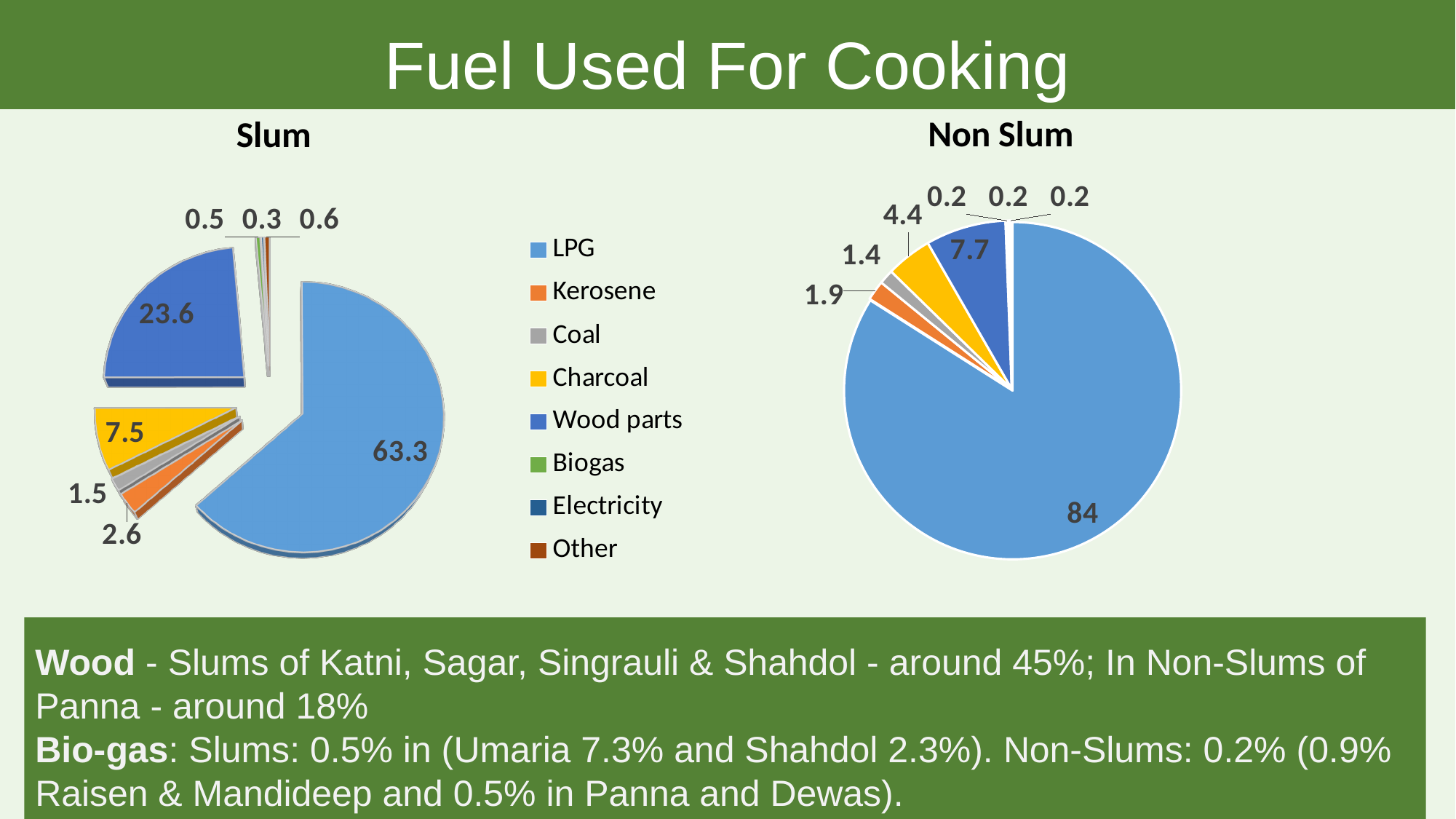
In the Slum pie chart, what is the value for LPG? 63.3 Is the Wood parts value larger in the Slum chart or the Non Slum chart? Slum In the Non Slum pie chart, what is the value for LPG? 84 How many fuel categories does the legend list? 8 What type of chart is used for the Slum and Non Slum data? Pie chart In the Slum pie chart, what is the value for Wood parts? 23.6 In the Non Slum pie chart, which fuel has the smallest slice among Kerosene, Coal and Charcoal? Coal In the Slum pie chart, which fuel has the largest slice? LPG What is the difference between the LPG values in the Non Slum and Slum pie charts? 20.7 In the Non Slum pie chart, what is the value for Wood parts? 7.7 In the Slum pie chart, what is the value for Charcoal? 7.5 In the Non Slum pie chart, what is the value for Kerosene? 1.9